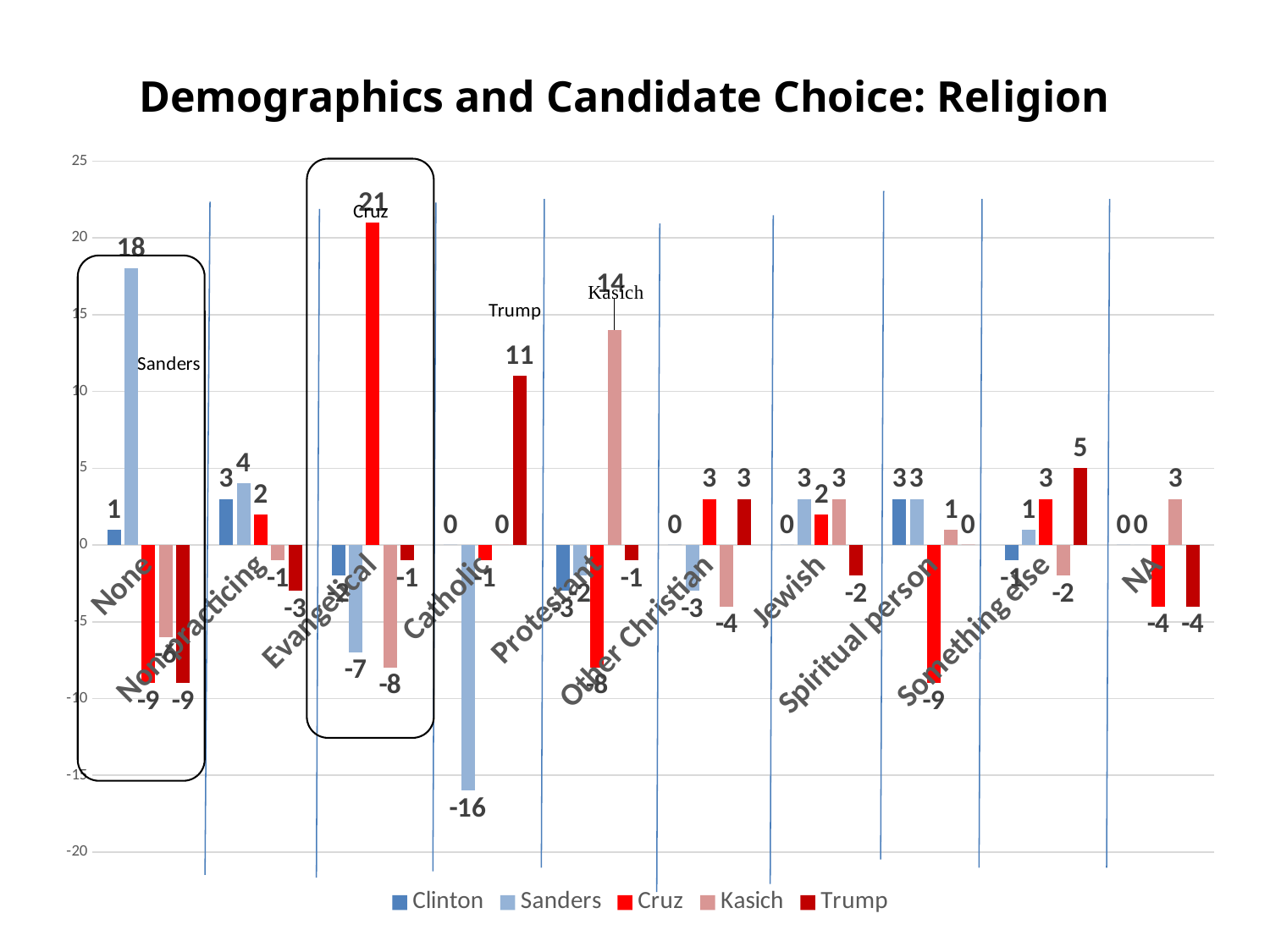
How many religion categories are shown on the x axis? 10 What is the difference between Cruz's value for Evangelical and Sanders's value for None? 3 What is the value for Kasich in the Protestant category? 14 What is the value for Trump in the Catholic category? 11 What is the value for Cruz in the Evangelical category? 21 What is the value for Sanders in the None category? 18 In which category does Cruz have the highest value? Evangelical Which is larger: Trump's value for Catholic or Kasich's value for Protestant? Kasich's value for Protestant What is the value for Sanders in the Catholic category? -16 What kind of chart is shown on the slide? Bar chart In which category does Sanders have the lowest value? Catholic How many series does the legend list? 5